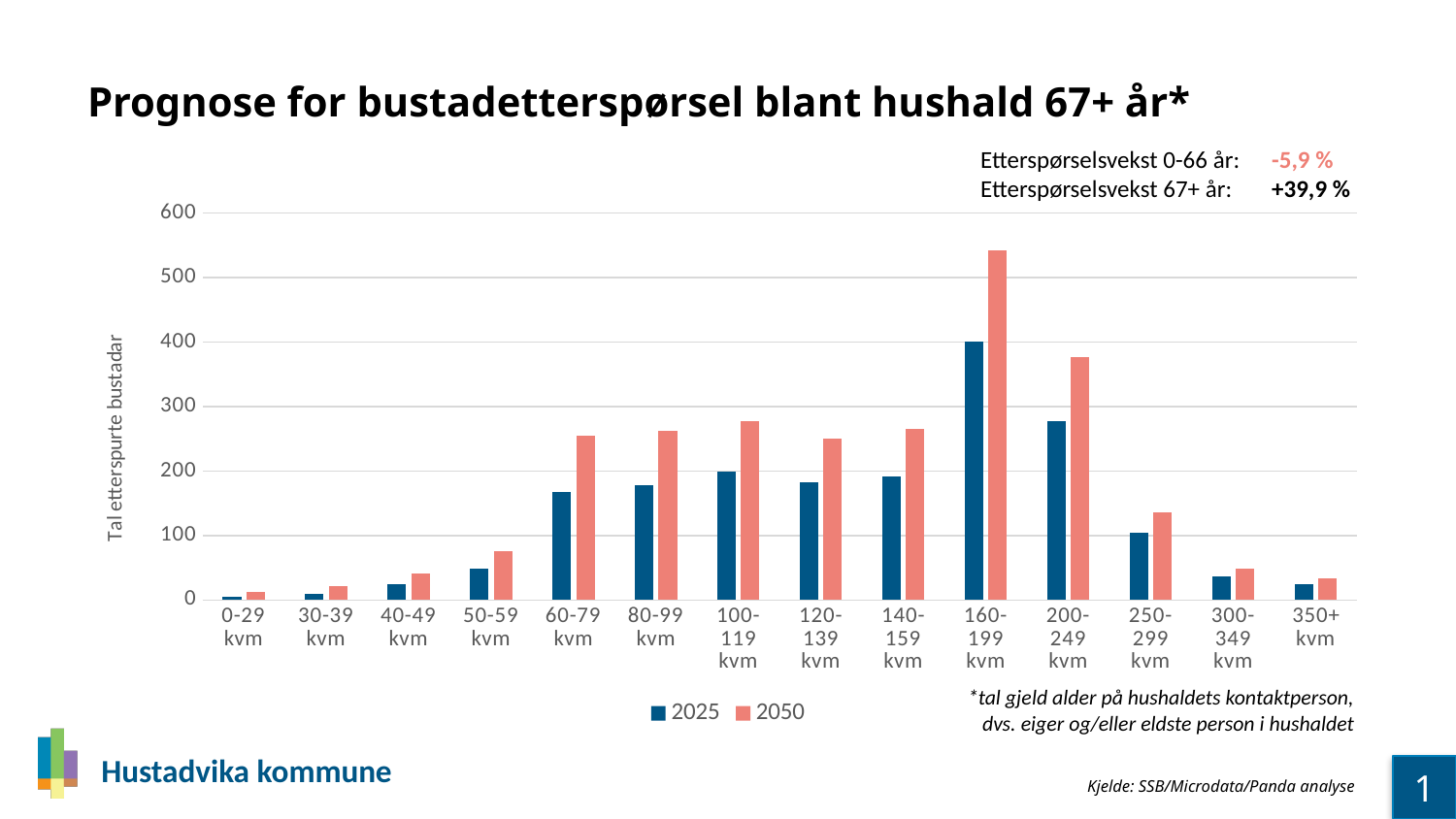
What is the title of the chart? Prognose for bustadetterspørsel blant hushald 67+ år* Which category has the highest value for the 2025 series? 160-199 kvm Which category has the lowest value for the 2025 series? 0-29 kvm For 160-199 kvm, which series has the larger value, 2025 or 2050? 2050 Is the 2025 value for 200-249 kvm greater or less than 300? less Is the 2050 value for 160-199 kvm greater or less than 500? greater How many series does the legend list? 2 How many size categories are shown on the x axis? 14 Which category has the highest value for the 2050 series? 160-199 kvm For the 2050 series, which is larger: 200-249 kvm or 100-119 kvm? 200-249 kvm Is the 2050 value for 60-79 kvm greater or less than 200? greater What kind of chart is shown on the slide? bar chart